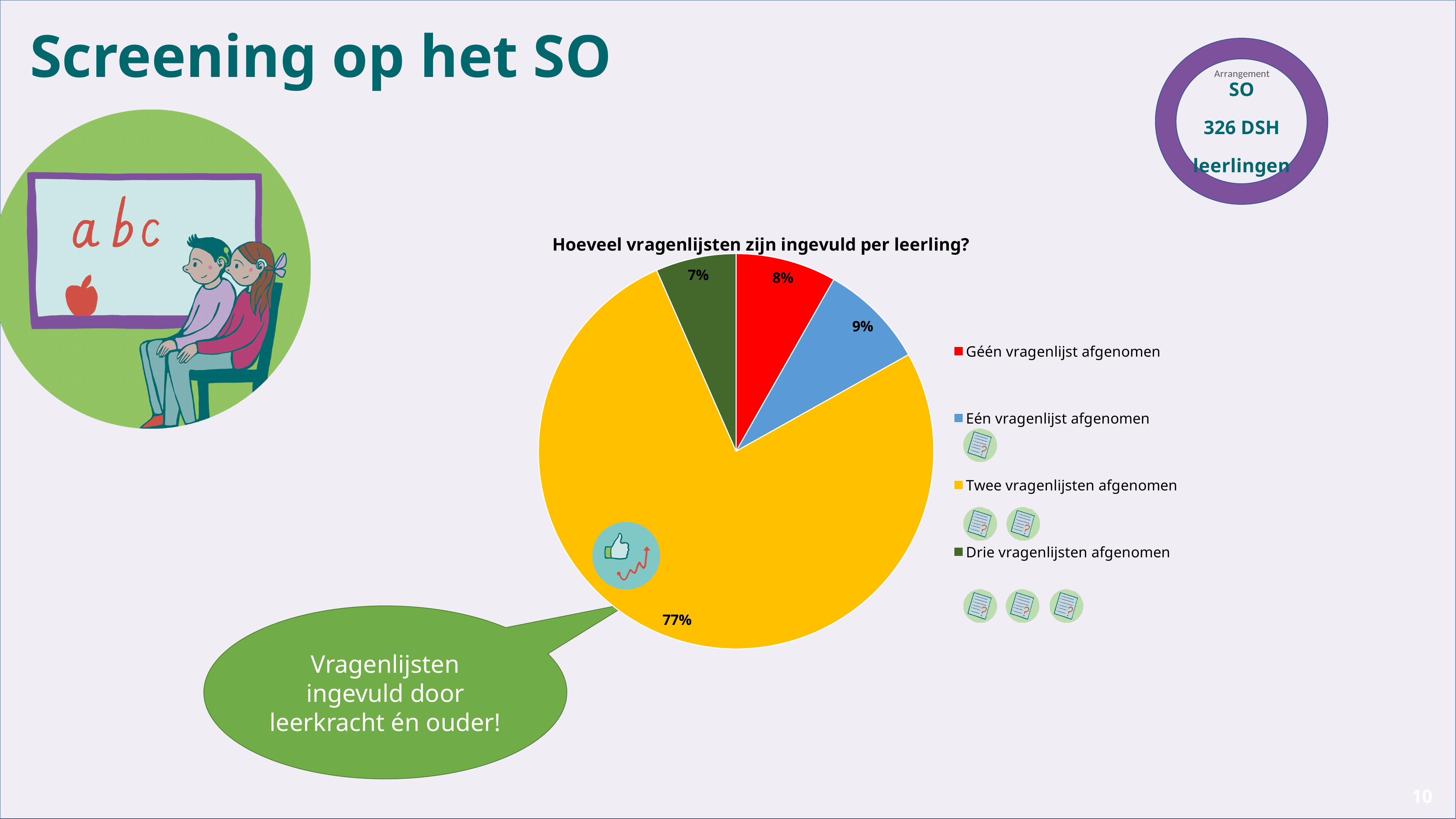
Which category has the smallest slice of the pie? Drie vragenlijsten afgenomen What colour is the slice for 'Drie vragenlijsten afgenomen'? dark green Which category has the largest slice of the pie? Twee vragenlijsten afgenomen What share of the pie is 'Drie vragenlijsten afgenomen'? 7% How many categories does the pie chart show? 4 What share of the pie is 'Twee vragenlijsten afgenomen'? 77% What kind of chart is shown on the slide? pie chart What share of the pie is 'Géén vragenlijst afgenomen'? 8% Which is larger: the share for 'Eén vragenlijst afgenomen' or 'Géén vragenlijst afgenomen'? Eén vragenlijst afgenomen What is the difference in percentage points between 'Twee vragenlijsten afgenomen' and 'Eén vragenlijst afgenomen'? 68 What is the title of the pie chart? Hoeveel vragenlijsten zijn ingevuld per leerling?